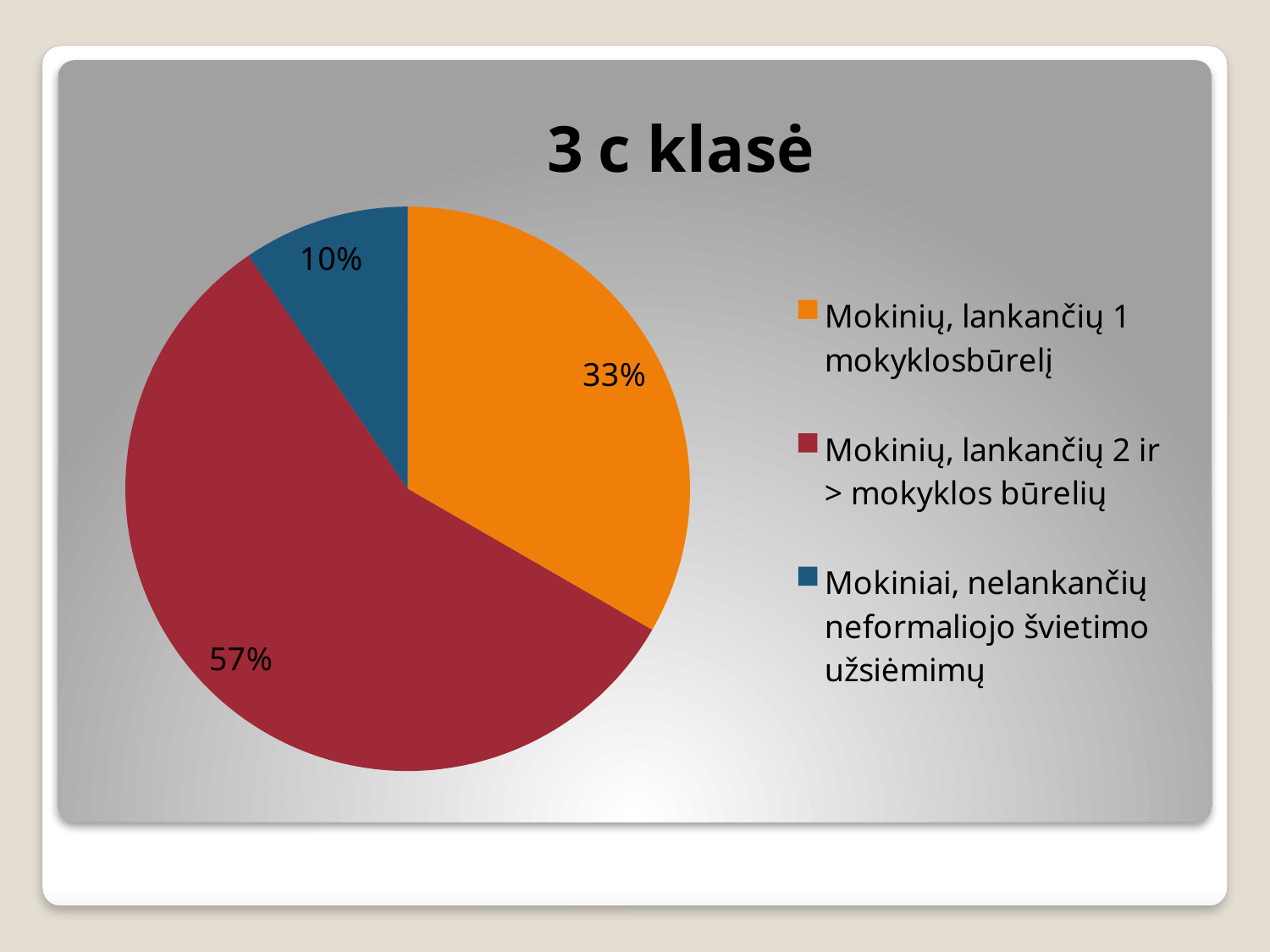
What share of the pie is labelled for 'Mokiniai, nelankančių neformaliojo švietimo užsiėmimų'? 10% Which is larger: the share for 'Mokinių, lankančių 1 mokyklosbūrelį' or the share for 'Mokiniai, nelankančių neformaliojo švietimo užsiėmimų'? Mokinių, lankančių 1 mokyklosbūrelį What colour is the slice for 'Mokiniai, nelankančių neformaliojo švietimo užsiėmimų'? blue What share of the pie is labelled for 'Mokinių, lankančių 2 ir > mokyklos būrelių'? 57% How many slices does the pie chart have? 3 What is the chart's title? 3 c klasė What share of the pie is labelled for 'Mokinių, lankančių 1 mokyklosbūrelį'? 33% Which category has the smallest slice of the pie? Mokiniai, nelankančių neformaliojo švietimo užsiėmimų What is the difference between the share for 'Mokinių, lankančių 2 ir > mokyklos būrelių' and the share for 'Mokinių, lankančių 1 mokyklosbūrelį'? 24% How many entries does the legend list? 3 Which category has the largest slice of the pie? Mokinių, lankančių 2 ir > mokyklos būrelių What kind of chart is shown on the slide? pie chart